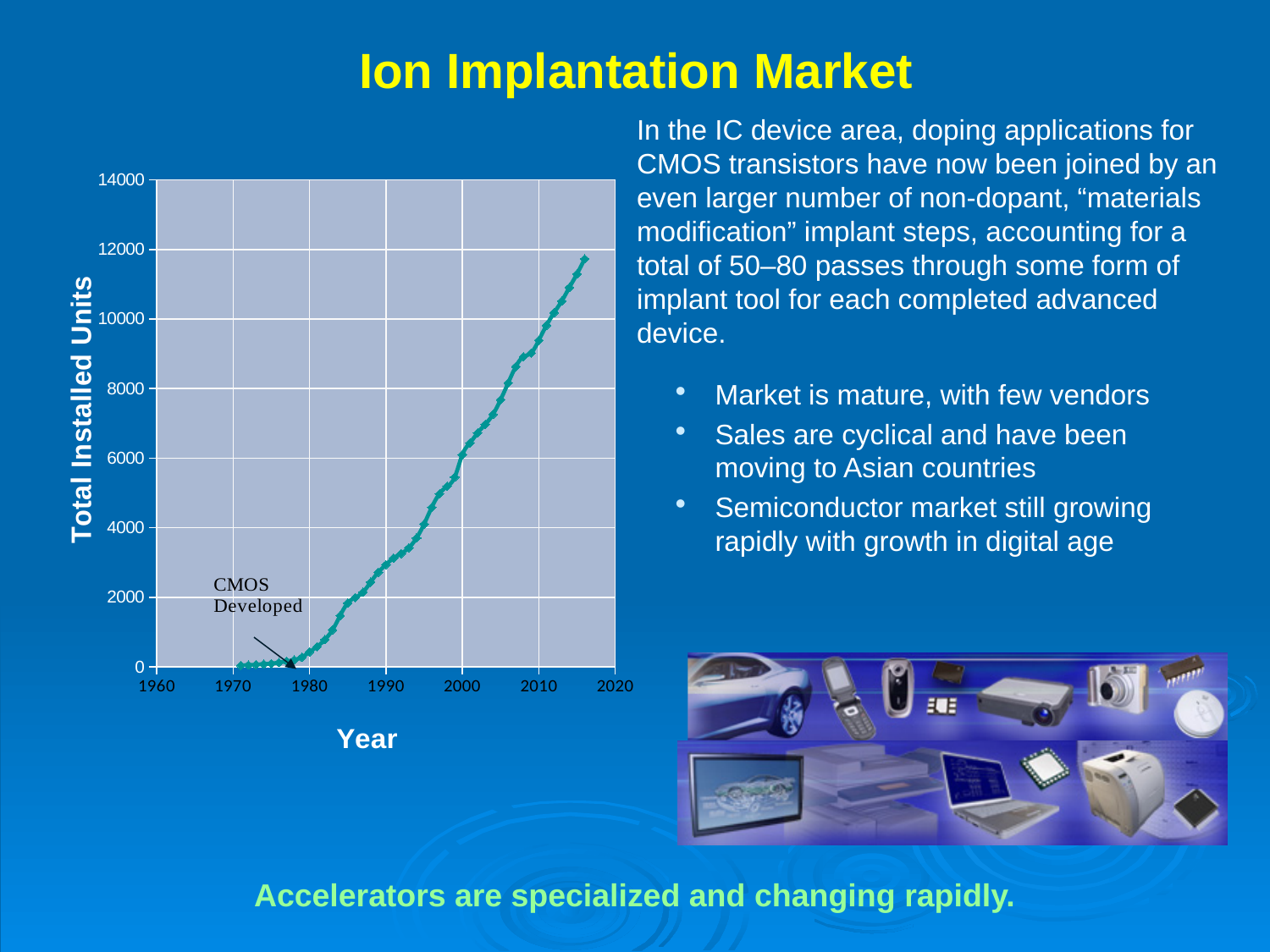
What is the label of the y axis of the chart? Total Installed Units Is the value for 1990 greater or less than 2000? greater Do the values in the chart rise or fall as the year increases along the x axis? rise Which year has the higher value, 2000 or 2010? 2010 What event is annotated on the chart near the late 1970s? CMOS Developed Is the last plotted value (around 2016) greater or less than 10000? greater Is the value for 2010 greater or less than 8000? greater What kind of chart is shown on the slide? line chart